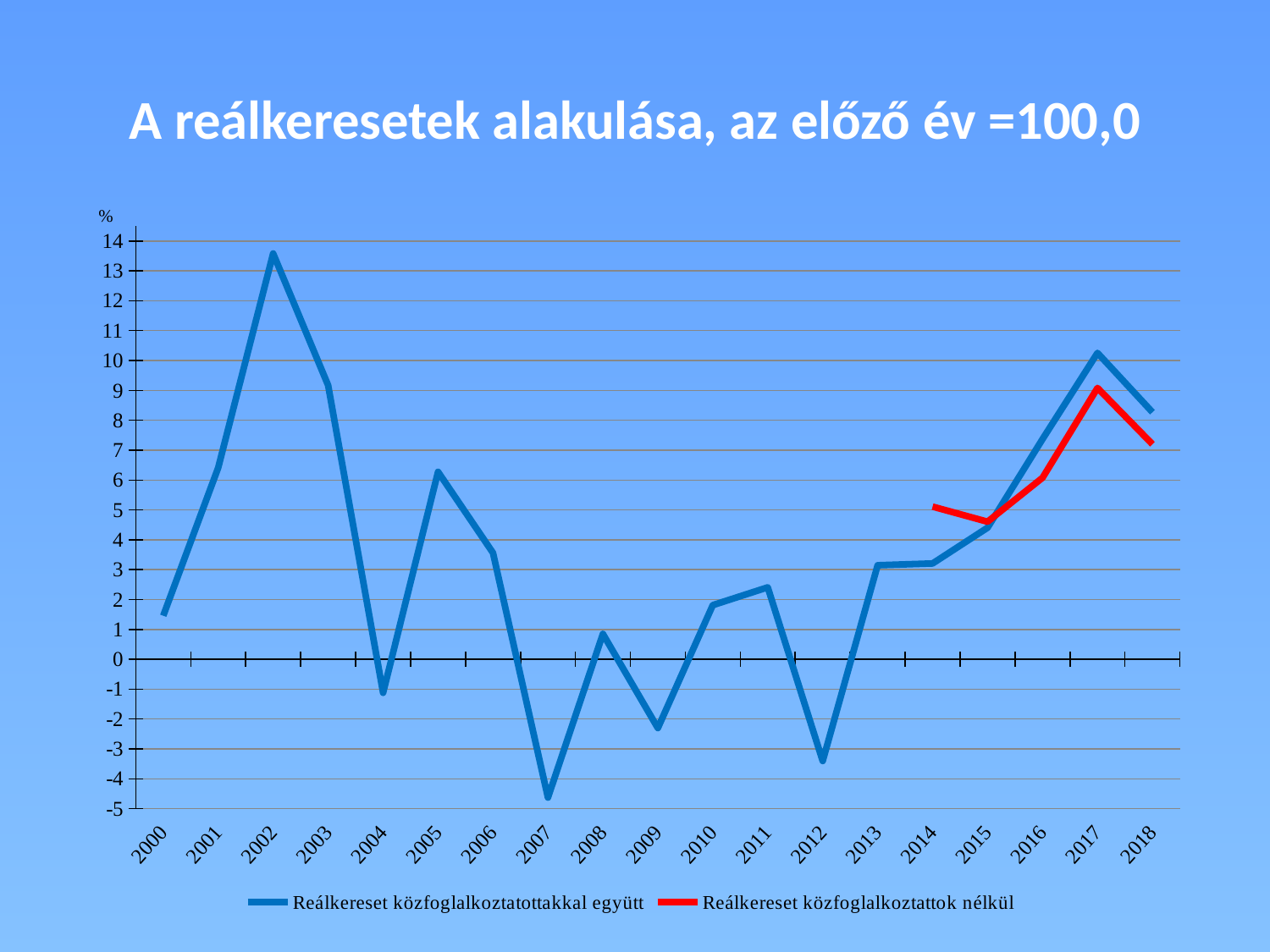
In 2017, which series has the higher value: 'Reálkereset közfoglalkoztatottakkal együtt' or 'Reálkereset közfoglalkoztattok nélkül'? Reálkereset közfoglalkoztatottakkal együtt Is the value for 2002 in the series 'Reálkereset közfoglalkoztatottakkal együtt' greater or less than 12? greater In which year does the series 'Reálkereset közfoglalkoztatottakkal együtt' reach its lowest value? 2007 What colour is the line for 'Reálkereset közfoglalkoztattok nélkül'? red Does the series 'Reálkereset közfoglalkoztatottakkal együtt' rise or fall from 2013 to 2017? rise In which year does the series 'Reálkereset közfoglalkoztattok nélkül' reach its highest value? 2017 What kind of chart is shown on the slide? line chart Is the value for 2007 in the series 'Reálkereset közfoglalkoztatottakkal együtt' greater or less than -4? less Is the value for 2012 in the series 'Reálkereset közfoglalkoztatottakkal együtt' greater or less than -2? less How many years are shown on the x axis? 19 How many series does the legend list? 2 In which year does the series 'Reálkereset közfoglalkoztatottakkal együtt' reach its highest value? 2002